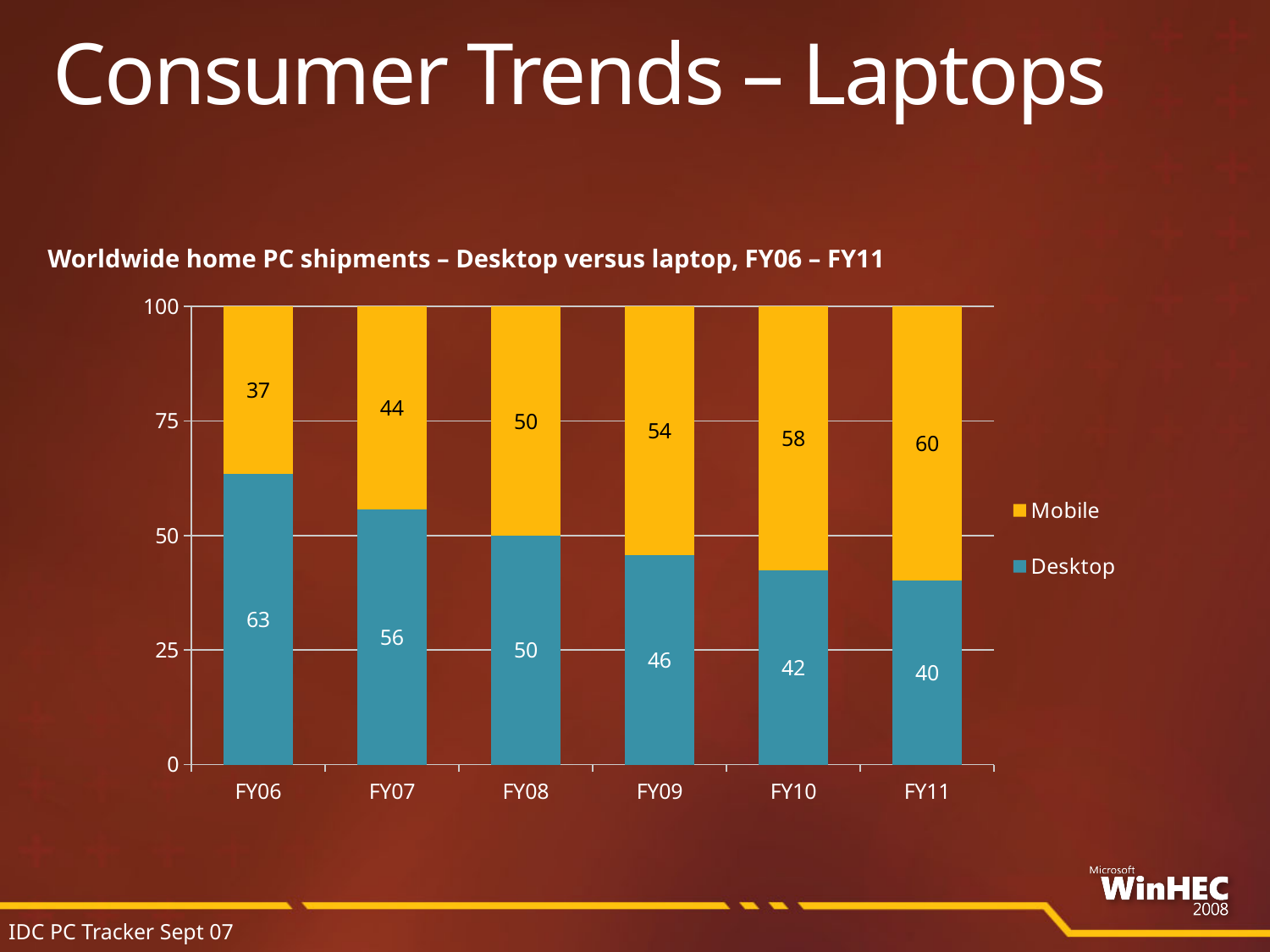
How many series does the legend list? 2 Which year has the highest Mobile value? FY11 What kind of chart is shown on the slide? Stacked bar chart What is the Desktop value for FY06? 63 What is the Mobile value for FY11? 60 What is the Mobile value for FY08? 50 Which year has the lowest Desktop value? FY11 What is the difference between the Desktop value for FY06 and the Desktop value for FY11? 23 How many years are shown on the x axis? 6 Does the Desktop value rise or fall from FY06 to FY11? Fall What is the total of the stacked bar for FY10? 100 Which is larger, the Mobile value for FY09 or the Desktop value for FY09? Mobile